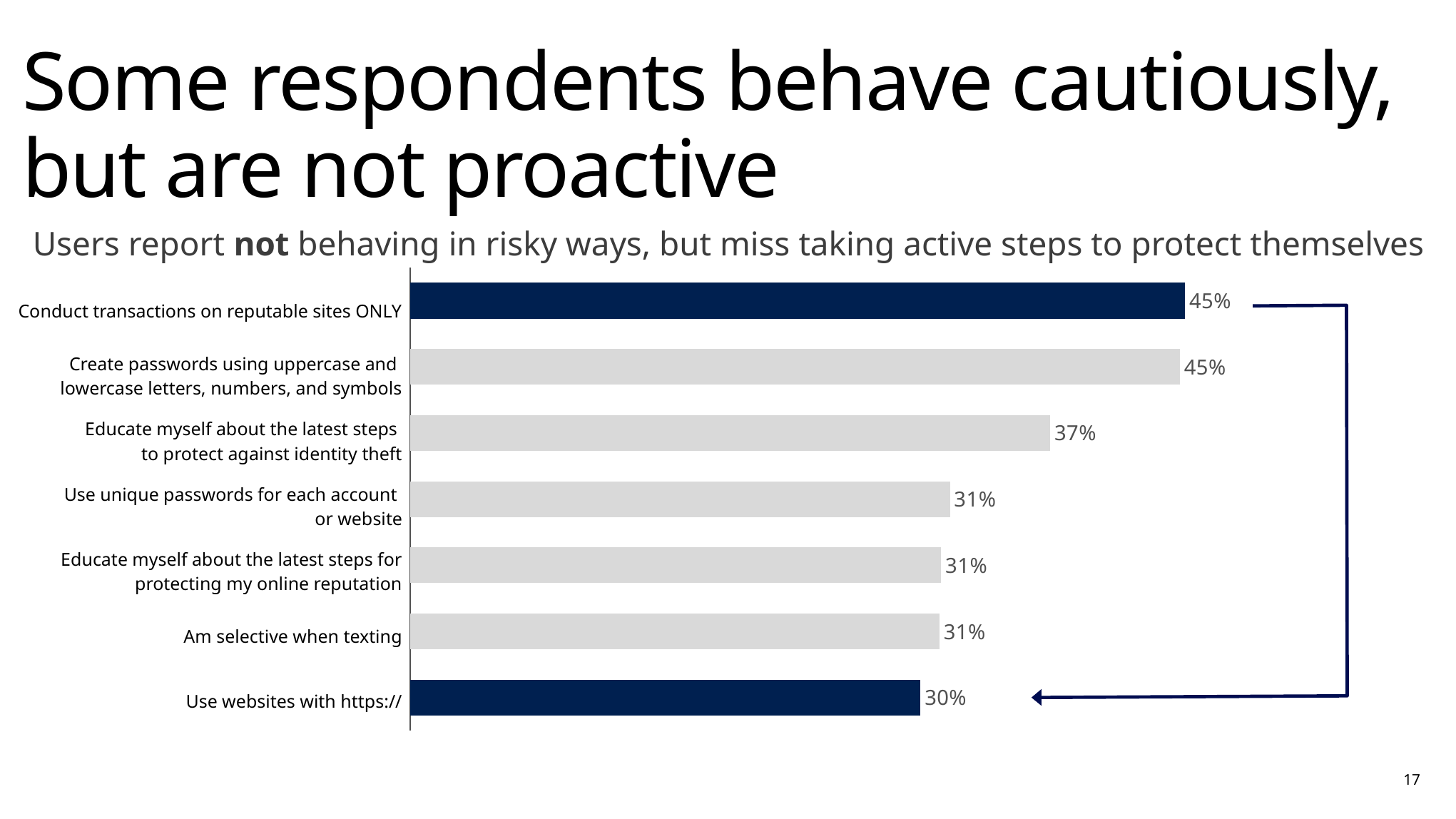
What is the value for "Am selective when texting"? 31% Which category has the lowest value in the chart? Use websites with https:// What is the difference between the value for "Conduct transactions on reputable sites ONLY" and the value for "Use websites with https://"? 15% What is the difference between "Educate myself about the latest steps to protect against identity theft" and "Use unique passwords for each account or website"? 6% What is the value for "Use websites with https://"? 30% What percentage of respondents use unique passwords for each account or website? 31% Which two categories are shown with dark blue bars instead of grey? Conduct transactions on reputable sites ONLY and Use websites with https:// How many categories are shown in the chart? 7 What kind of chart is shown on the slide? Bar chart Which is larger: the value for "Create passwords using uppercase and lowercase letters, numbers, and symbols" or the value for "Educate myself about the latest steps for protecting my online reputation"? Create passwords using uppercase and lowercase letters, numbers, and symbols What percentage of respondents report that they conduct transactions on reputable sites only? 45% What percentage of respondents educate themselves about the latest steps to protect against identity theft? 37%